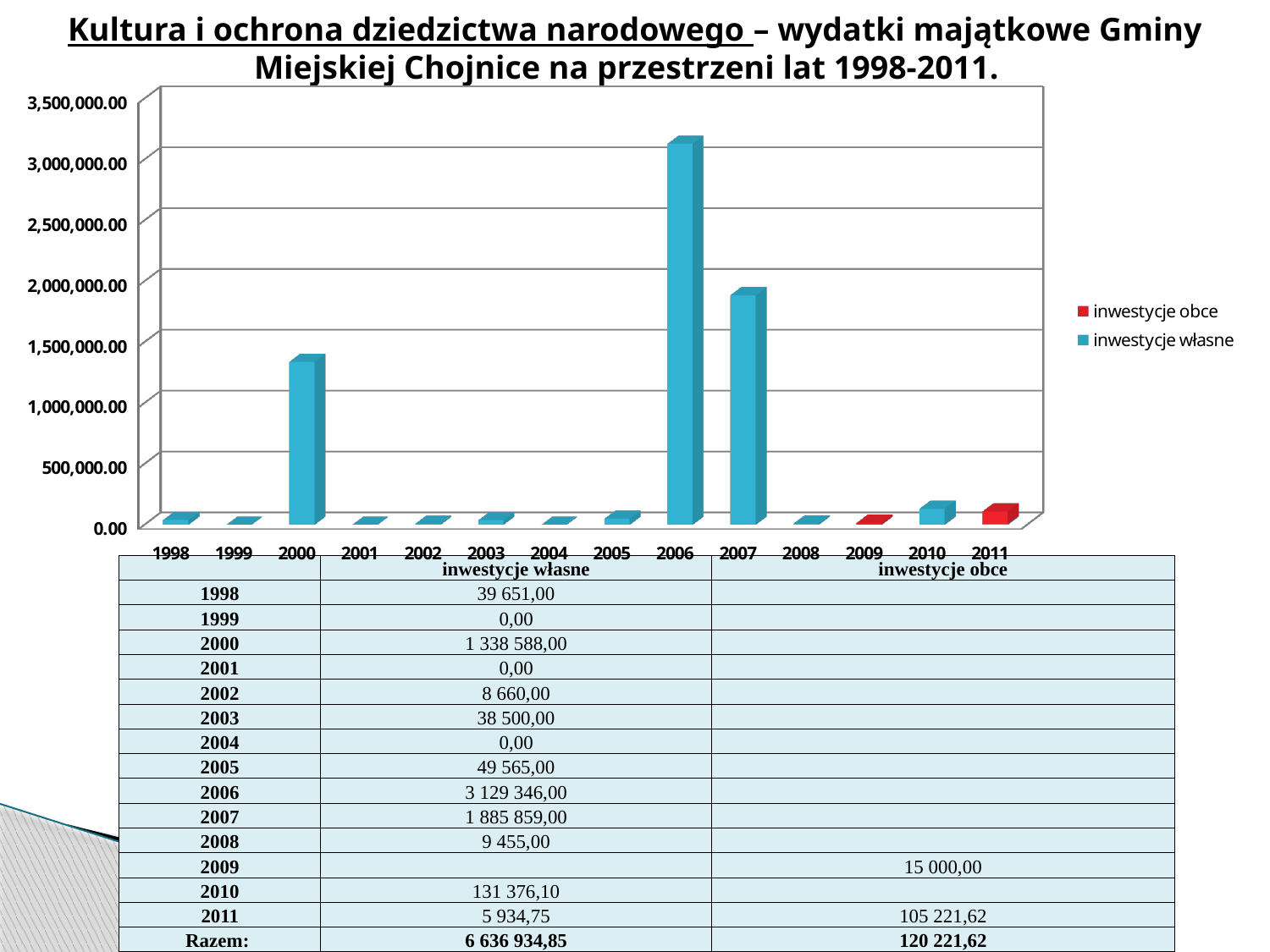
How many series does the legend list? 2 What colour represents inwestycje obce in the chart? red What is the difference between inwestycje własne in 2006 and in 2007? 1 243 487,00 What is the value of inwestycje własne for 2006? 3 129 346,00 What is the value of inwestycje obce for 2011? 105 221,62 Which is larger, inwestycje własne in 2000 or in 2007? 2007 How many years are shown along the x axis of the chart? 14 Is the value for inwestycje własne in 2000 greater or less than 1,000,000.00? greater What is the value of inwestycje obce for 2009? 15 000,00 What kind of chart is shown on the slide? bar chart Which year has the highest value for inwestycje własne? 2006 What is the value of inwestycje własne for 2007? 1 885 859,00